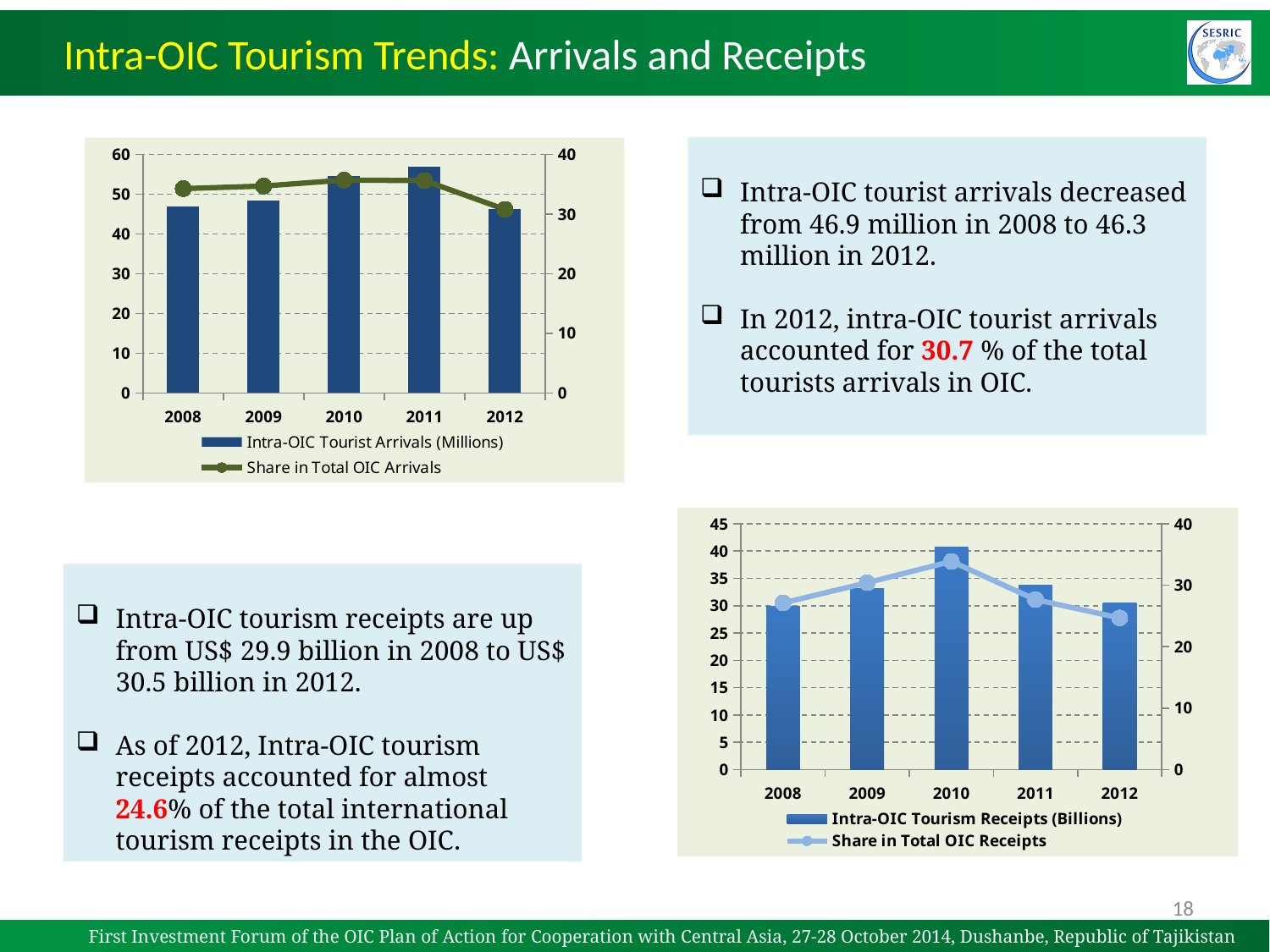
In the top-left chart, which year has the lowest value for Share in Total OIC Arrivals? 2012 In the bottom-right chart, what does the legend label the line series? Share in Total OIC Receipts In the top-left chart, is the Intra-OIC Tourist Arrivals bar for 2011 greater or less than 50? greater In the bottom-right chart, which year has the highest bar for Intra-OIC Tourism Receipts (Billions)? 2010 In the bottom-right chart, is the Share in Total OIC Receipts for 2012 greater or less than 30? less In the top-left chart, how many years are shown on the x axis? 5 In the top-left chart, is the Intra-OIC Tourist Arrivals bar for 2008 greater or less than 50? less In the bottom-right chart, which year has the lowest value for Share in Total OIC Receipts? 2012 What type of chart is the top-left chart on the slide? Combined bar and line chart In the top-left chart, which is larger, the Intra-OIC Tourist Arrivals bar for 2010 or for 2011? 2011 In the top-left chart, which year has the highest bar for Intra-OIC Tourist Arrivals (Millions)? 2011 In the top-left chart, how many series does the legend list? 2